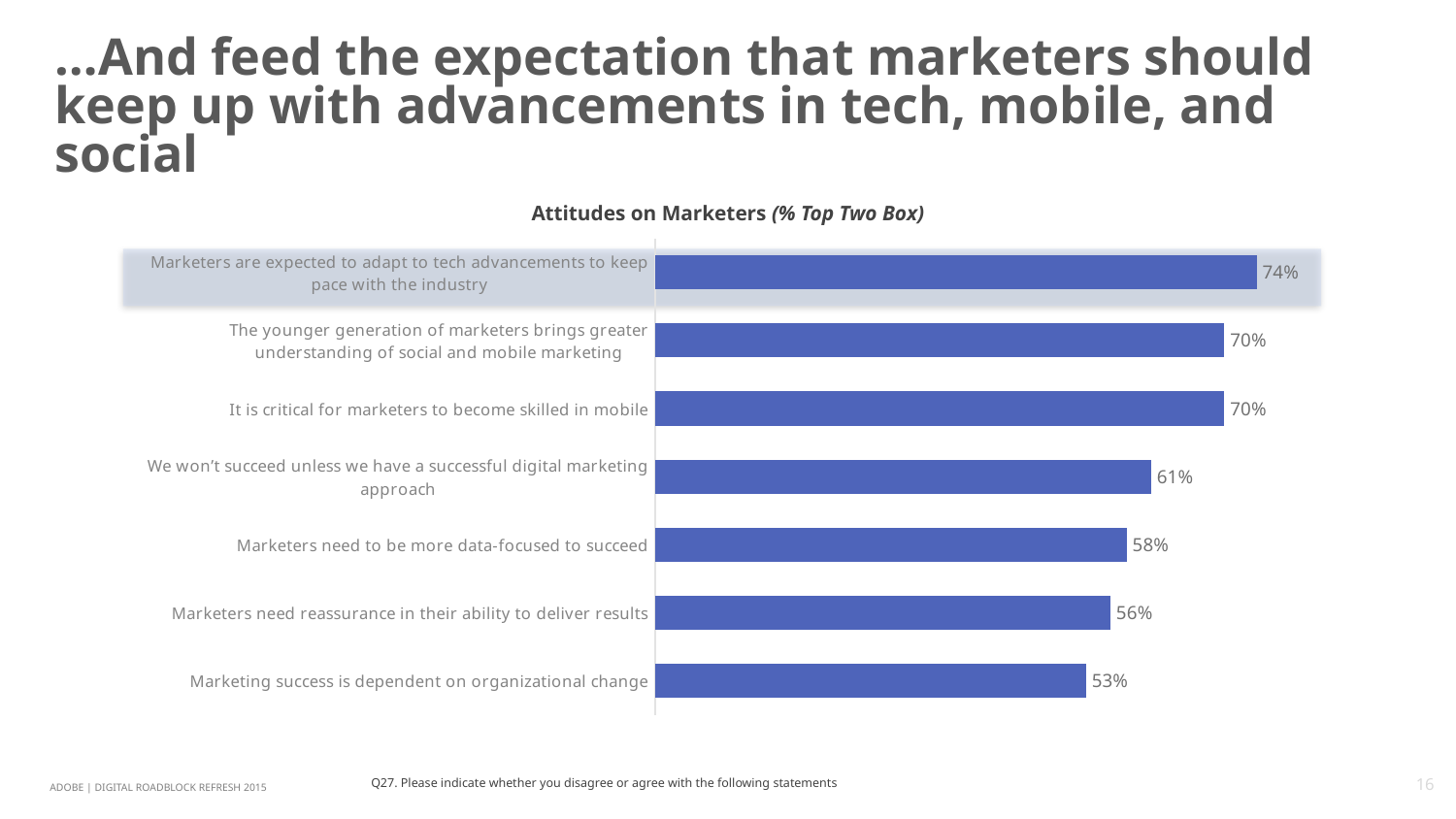
Which is larger: the value for "It is critical for marketers to become skilled in mobile" or the value for "Marketers need to be more data-focused to succeed"? It is critical for marketers to become skilled in mobile What is the title of the chart? Attitudes on Marketers (% Top Two Box) What is the difference between "We won't succeed unless we have a successful digital marketing approach" and "Marketers need reassurance in their ability to deliver results"? 5 percentage points What is the value for "Marketers need to be more data-focused to succeed"? 58% How many statements are shown in the chart? 7 Which statement has the lowest percentage in the chart? Marketing success is dependent on organizational change What type of chart is shown on the slide? Bar chart What percentage of respondents agree that marketers are expected to adapt to tech advancements to keep pace with the industry? 74% How many statements have a value of 70%? 2 What is the difference between the highest value (74%) and the lowest value (53%) in the chart? 21 percentage points Which statement has the highest percentage in the chart? Marketers are expected to adapt to tech advancements to keep pace with the industry What is the value for "Marketing success is dependent on organizational change"? 53%